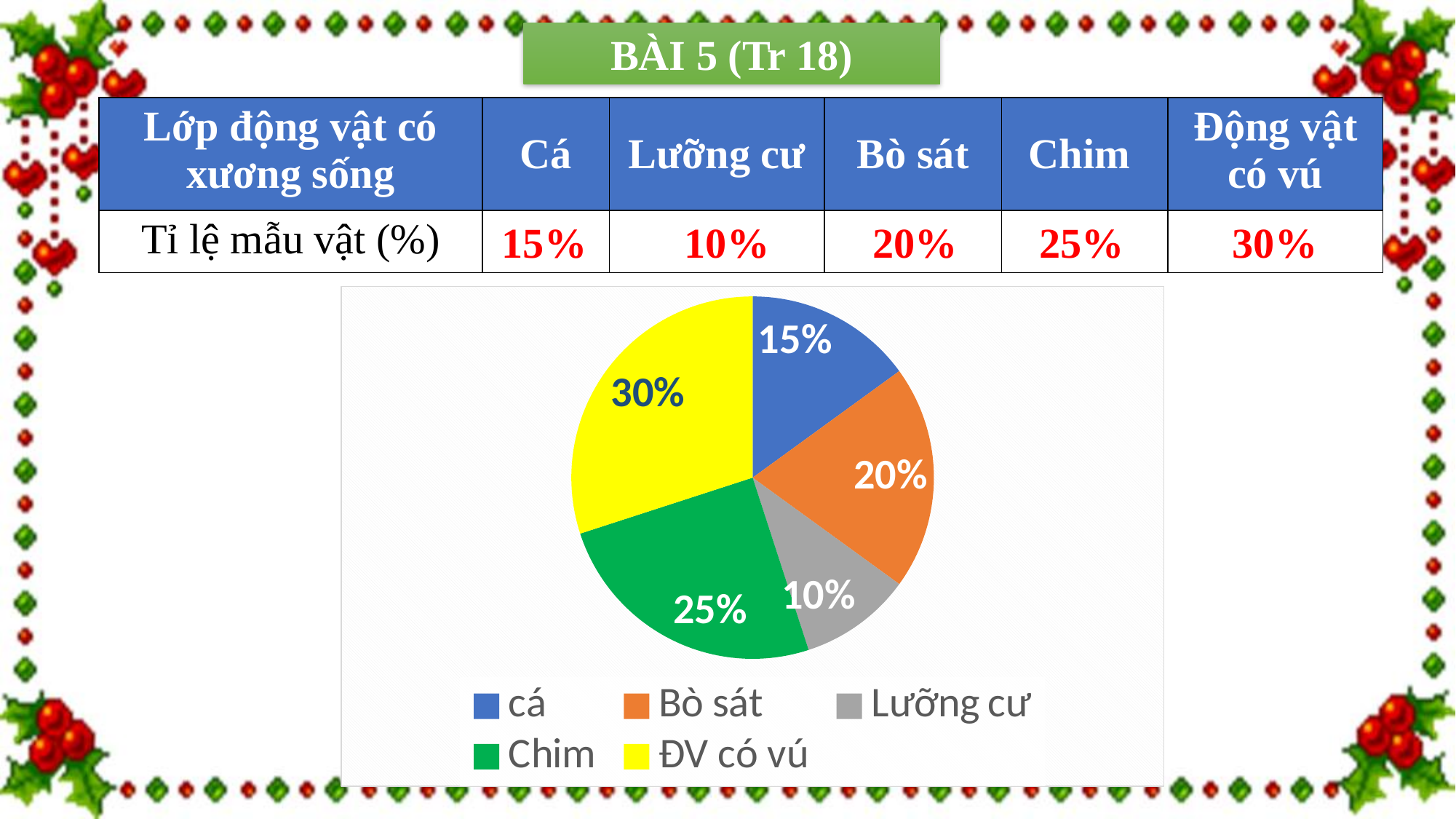
What percentage does the pie chart show for Chim? 25% What is the difference between the percentages for ĐV có vú and cá in the pie chart? 15% Which is larger in the pie chart, the slice for Chim or the slice for Bò sát? Chim What percentage does the pie chart show for Lưỡng cư? 10% What percentage does the pie chart show for Bò sát? 20% How many slices does the pie chart have? 5 Which category has the largest slice in the pie chart? ĐV có vú What colour is the slice for Chim in the pie chart? green What percentage does the pie chart show for cá? 15% Which category has the smallest slice in the pie chart? Lưỡng cư What type of chart is shown on the slide? pie chart What percentage does the pie chart show for ĐV có vú? 30%